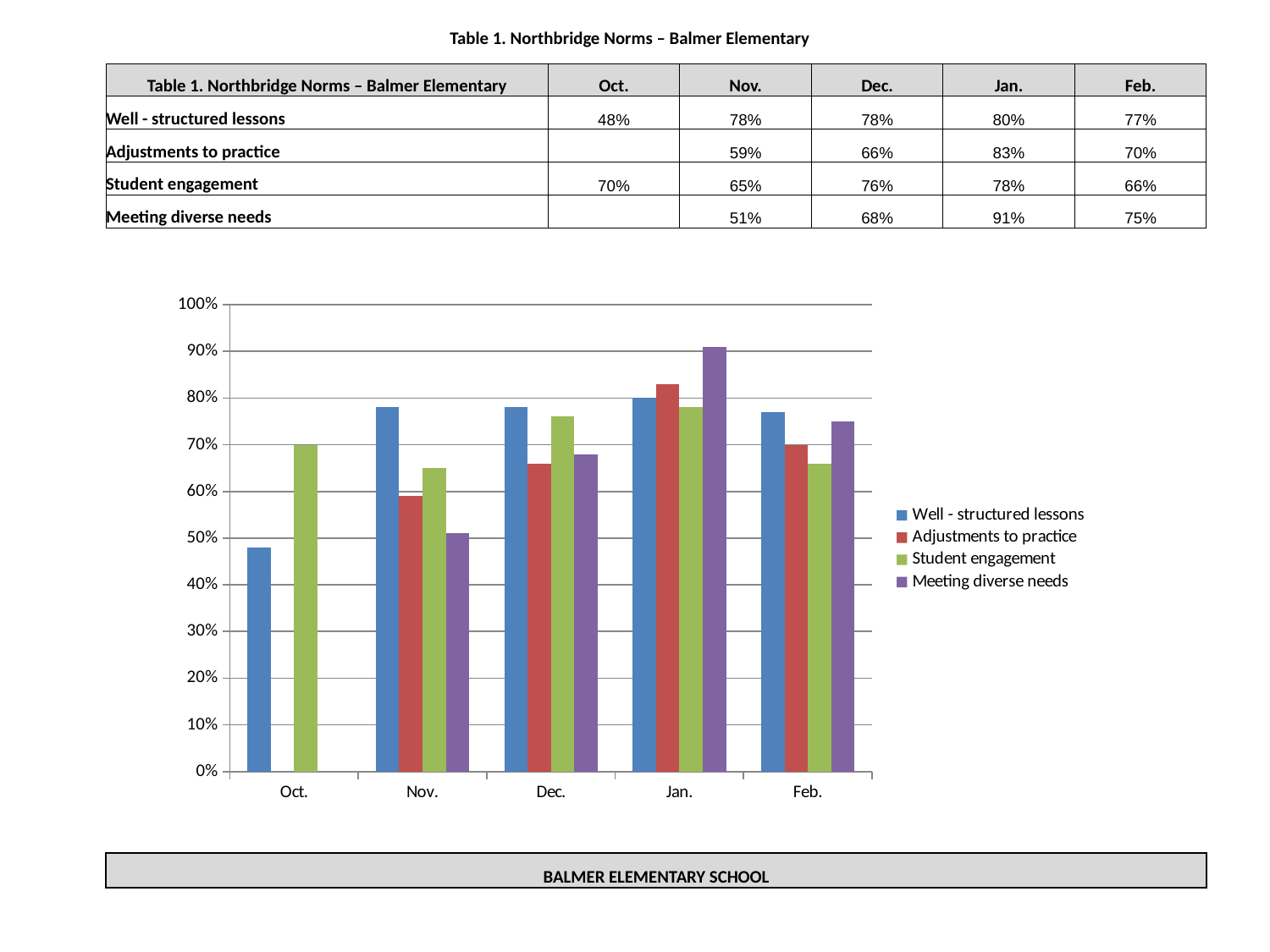
In which month is Meeting diverse needs highest? Jan. In which month is Well - structured lessons lowest? Oct. Which is larger in Dec.: Student engagement or Adjustments to practice? Student engagement What is the value for Well - structured lessons in Oct.? 48% What is the value for Adjustments to practice in Nov.? 59% Is the value for Meeting diverse needs in Jan. greater or less than 90%? greater What is the value for Meeting diverse needs in Jan.? 91% What is the difference between Meeting diverse needs in Jan. and in Nov.? 40% What kind of chart is shown on the slide? bar chart Which series is shown in purple in the chart legend? Meeting diverse needs How many series does the chart legend list? 4 How many months are shown on the x axis of the chart? 5